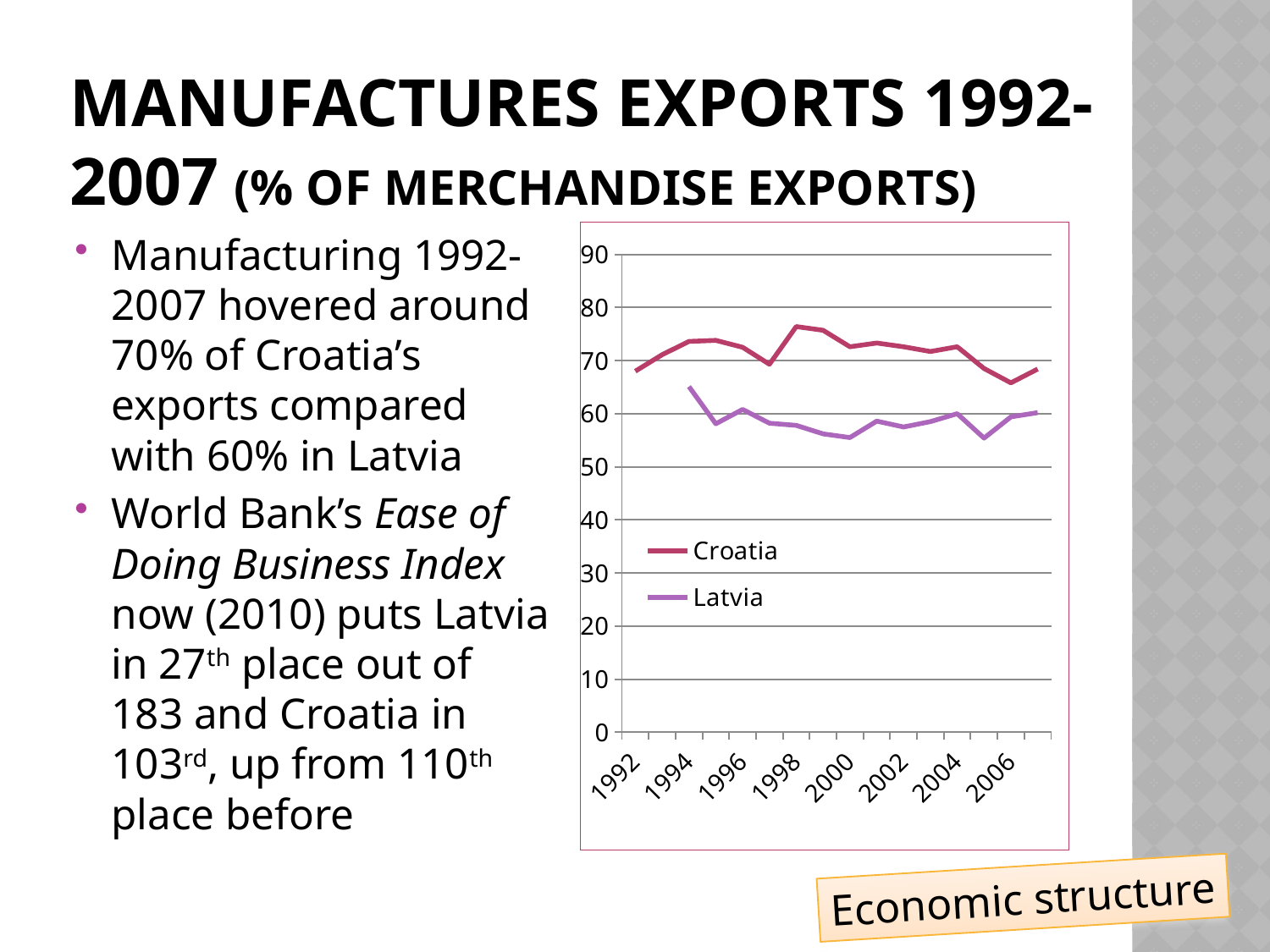
Is the value for Latvia in 1994 greater or less than 60? greater What kind of chart is shown on the slide? Line chart Is the value for Latvia in 2000 greater or less than 60? less Is the value for Croatia in 1998 greater or less than 70? greater Which two countries are shown in the chart's legend? Croatia and Latvia What colour is the Latvia line in the chart? Purple Does the Latvia line rise or fall between 1994 and 1995? Fall How many year labels are shown on the x axis of the chart? 8 Which series has the higher value in 2000, Croatia or Latvia? Croatia How many series does the chart's legend list? 2 Which series reaches the highest value anywhere on the chart? Croatia